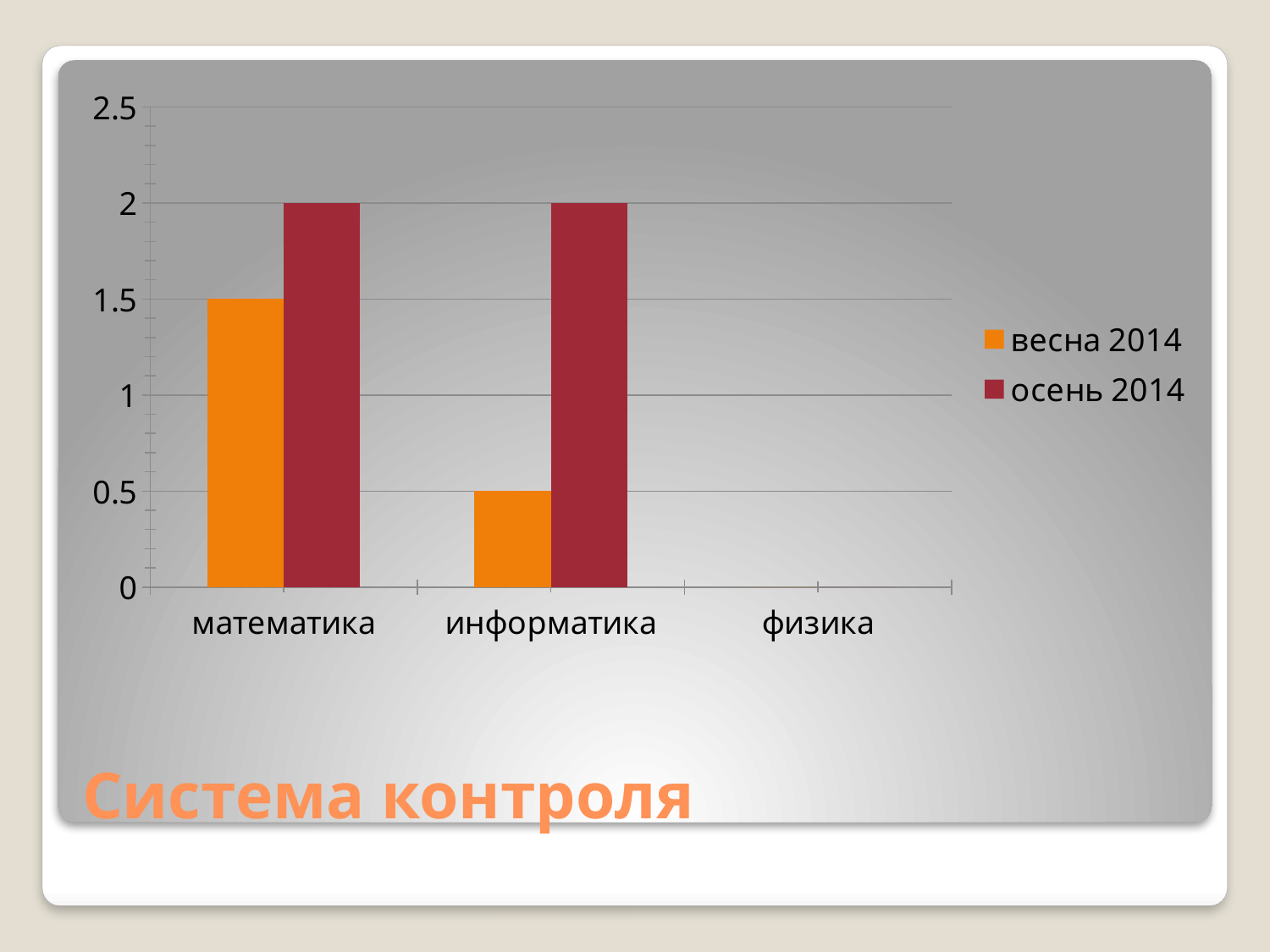
What is the difference between the осень 2014 and весна 2014 values for информатика? 1.5 How many categories are shown on the x axis? 3 How many series does the legend list? 2 What kind of chart is shown on the slide? bar chart What is the difference between the осень 2014 and весна 2014 values for математика? 0.5 What is the value for информатика in the осень 2014 series? 2 What is the value for математика in the весна 2014 series? 1.5 Is the весна 2014 value for математика greater or less than 1? greater In the весна 2014 series, which is larger: математика or информатика? математика Which category on the x axis has no bars plotted? физика What is the value for математика in the осень 2014 series? 2 What is the value for информатика in the весна 2014 series? 0.5